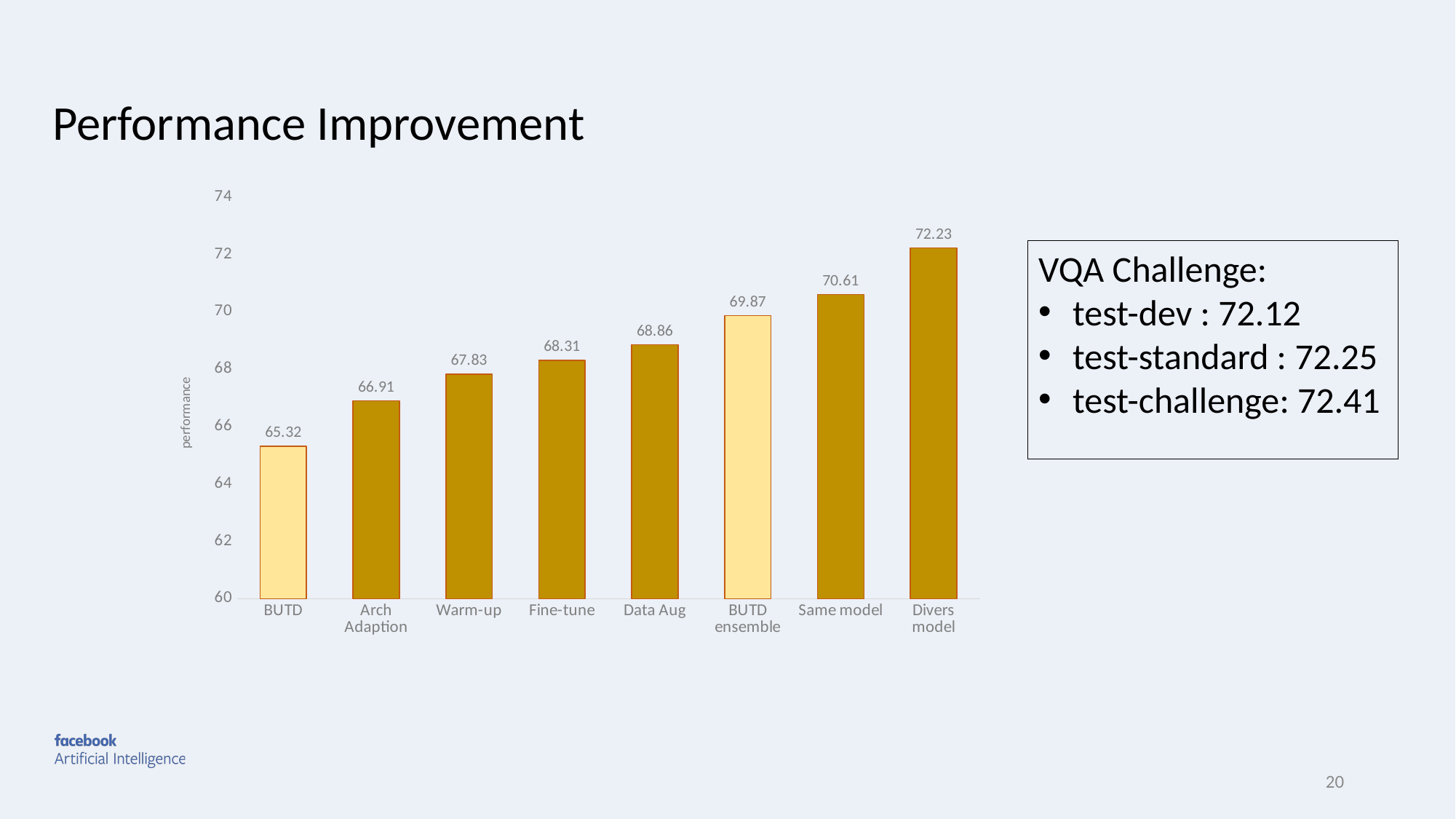
What is the performance value for BUTD? 65.32 What is the difference in performance between Same model and BUTD ensemble? 0.74 What is the difference in performance between Divers model and BUTD? 6.91 What is the performance value for BUTD ensemble? 69.87 Which has a higher performance value, Warm-up or Fine-tune? Fine-tune Which category has the highest performance? Divers model What kind of chart is shown on the slide? bar chart Which category has the lowest performance? BUTD What is the performance value for Data Aug? 68.86 Is the value for Arch Adaption greater or less than 68? less Do the performance values rise or fall from left to right along the x axis? rise How many categories are shown on the x axis? 8